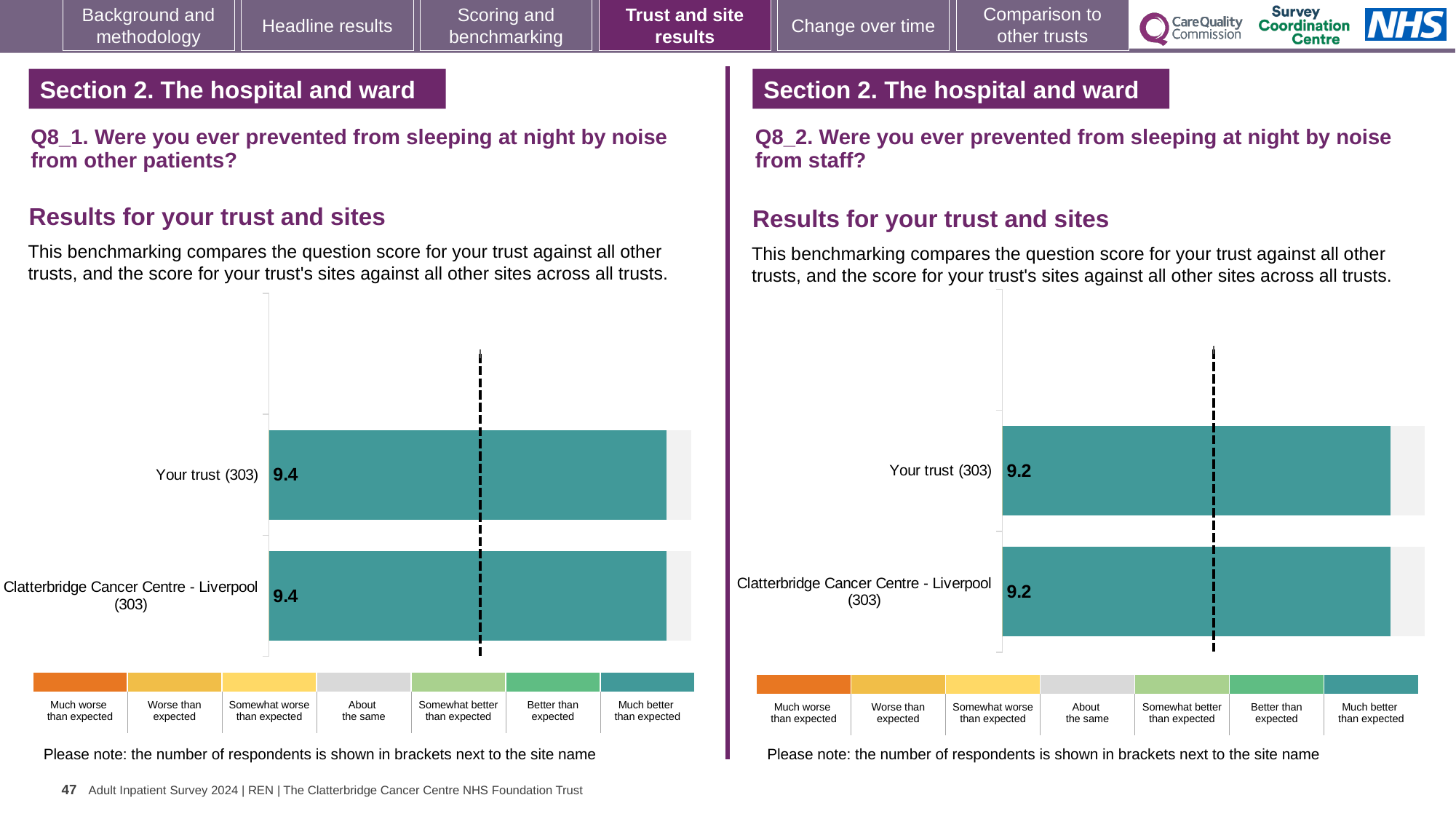
Is the score for Your trust higher in the left chart (Q8_1) or in the right chart (Q8_2)? Left chart (Q8_1) In the left chart (Q8_1, noise from other patients), what is the score for Your trust (303)? 9.4 In the left chart (Q8_1, noise from other patients), what is the score for Clatterbridge Cancer Centre - Liverpool (303)? 9.4 In the right chart (Q8_2, noise from staff), what is the score for Your trust (303)? 9.2 How many benchmark categories does the colour key below the left chart (Q8_1) list? 7 In the right chart (Q8_2, noise from staff), what is the score for Clatterbridge Cancer Centre - Liverpool (303)? 9.2 How many bars are plotted in the left chart (Q8_1)? 2 How many respondents are shown in brackets next to Your trust in the right chart (Q8_2)? 303 What kind of chart is used in the left chart (Q8_1)? Bar chart What is the difference between the Your trust score in the left chart (Q8_1) and the Your trust score in the right chart (Q8_2)? 0.2 In the left chart (Q8_1), is the score for Your trust greater or less than 9? greater How many bars are plotted in the right chart (Q8_2)? 2